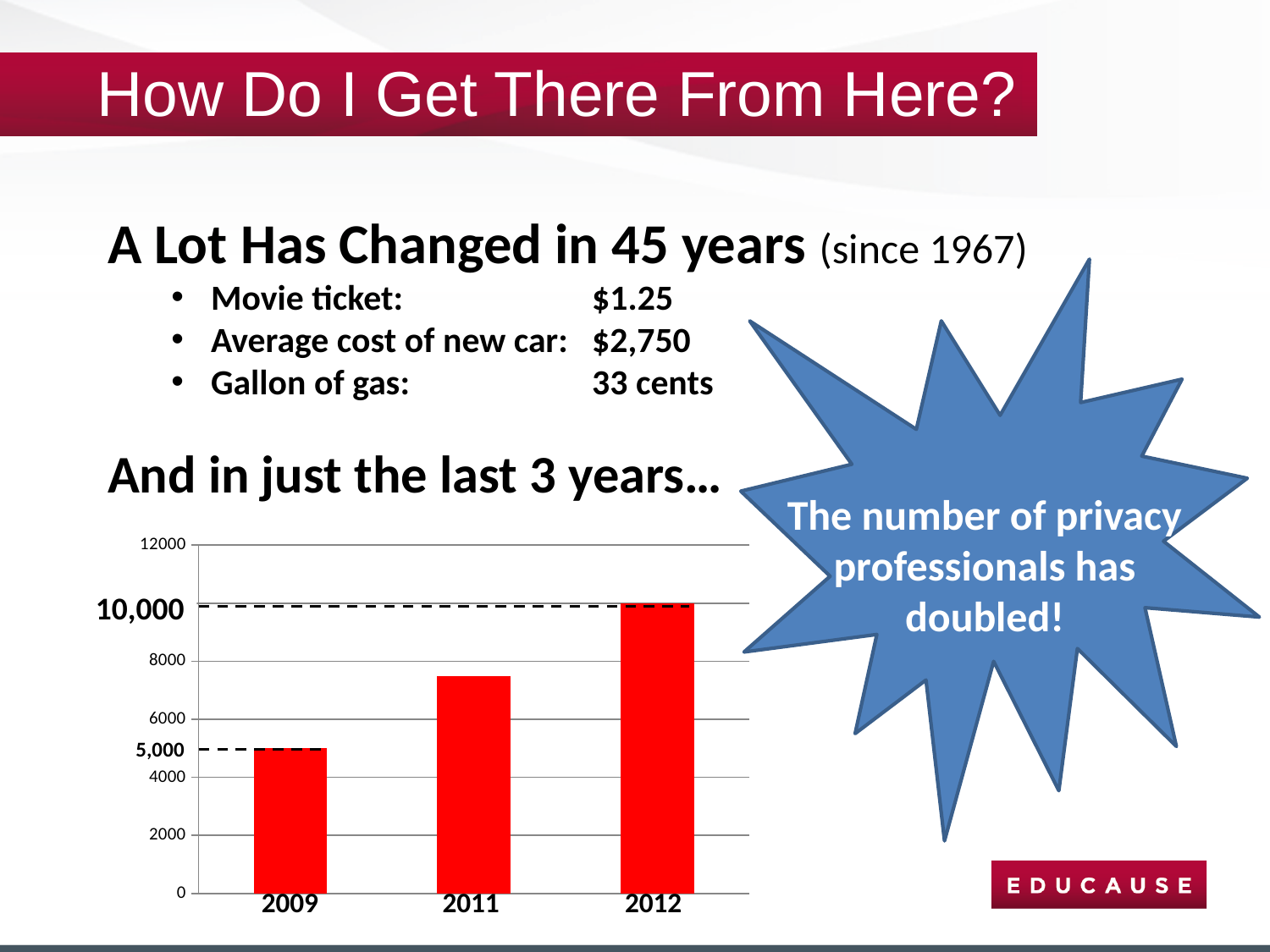
What type of chart is shown on the slide? bar chart Which year has the lowest bar in the chart? 2009 What is the highest value shown on the chart's vertical axis? 12000 Is the value for 2011 greater or less than 6000? greater Is the value for 2011 greater or less than 8000? less Do the values rise or fall from 2009 to 2012? rise Which is larger, the value for 2011 or the value for 2012? 2012 What is the difference between the values for 2012 and 2009? 5,000 How many bars (categories) does the chart show? 3 What is the value for 2009 in the chart? 5,000 Which year has the highest bar in the chart? 2012 What is the value for 2012 in the chart? 10,000